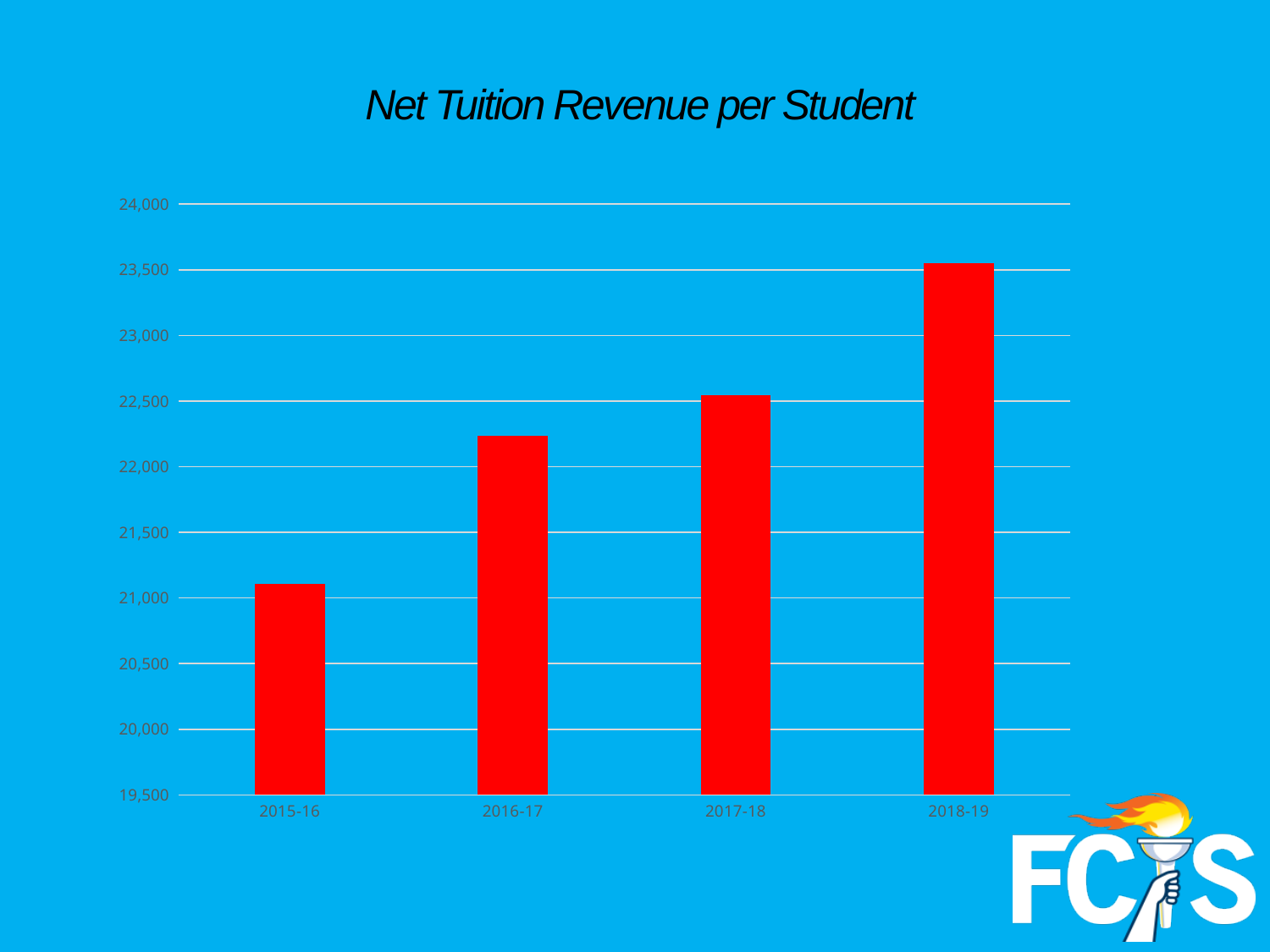
Which is larger, the value for 2016-17 or the value for 2018-19? 2018-19 Is the value for 2017-18 greater or less than 23,000? less Is the value for 2016-17 greater or less than 22,000? greater Is the value for 2015-16 greater or less than 21,500? less How many academic years are plotted on the chart? 4 Which year has the lowest net tuition revenue per student? 2015-16 Which year has the highest net tuition revenue per student? 2018-19 What colour are the bars in the chart? red What kind of chart is shown on the slide? bar chart What is the title of the chart? Net Tuition Revenue per Student Do the values rise or fall from 2015-16 to 2018-19? rise